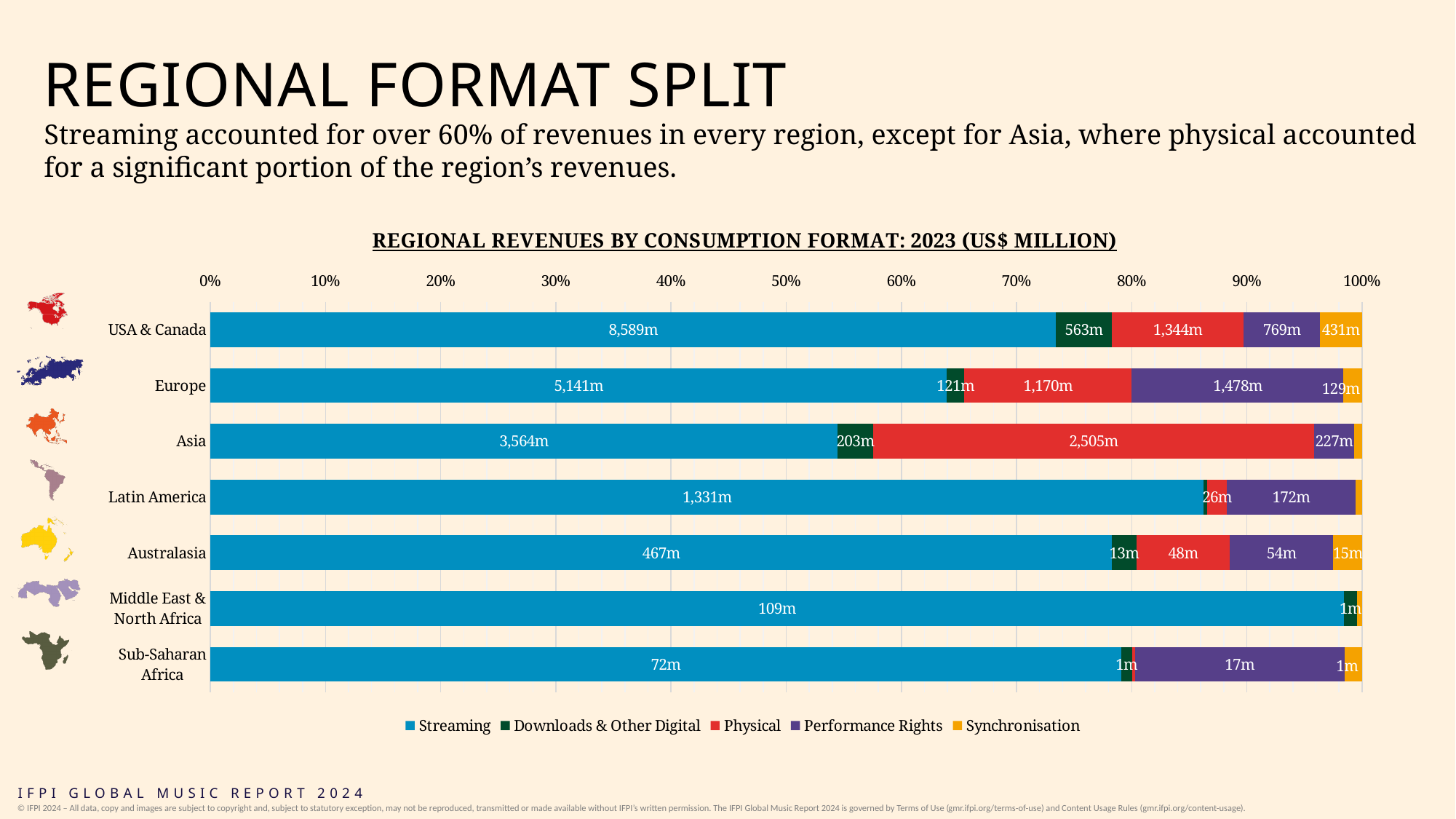
What is the difference between the Physical revenue of USA & Canada and that of Europe? 174m Which region has the highest Physical revenue? Asia Which region has the highest Streaming revenue? USA & Canada What is the Physical revenue for Australasia? 48m What is the Performance Rights revenue for Europe? 1,478m Is the Streaming share of Asia's bar greater or less than 50%? greater How many regions are shown in the chart? 7 How many series does the legend list? 5 What is the total revenue for Australasia across all formats? 597m For Europe, which is larger: Physical revenue or Performance Rights revenue? Performance Rights What is the Streaming revenue for USA & Canada? 8,589m What is the Physical revenue for Asia? 2,505m